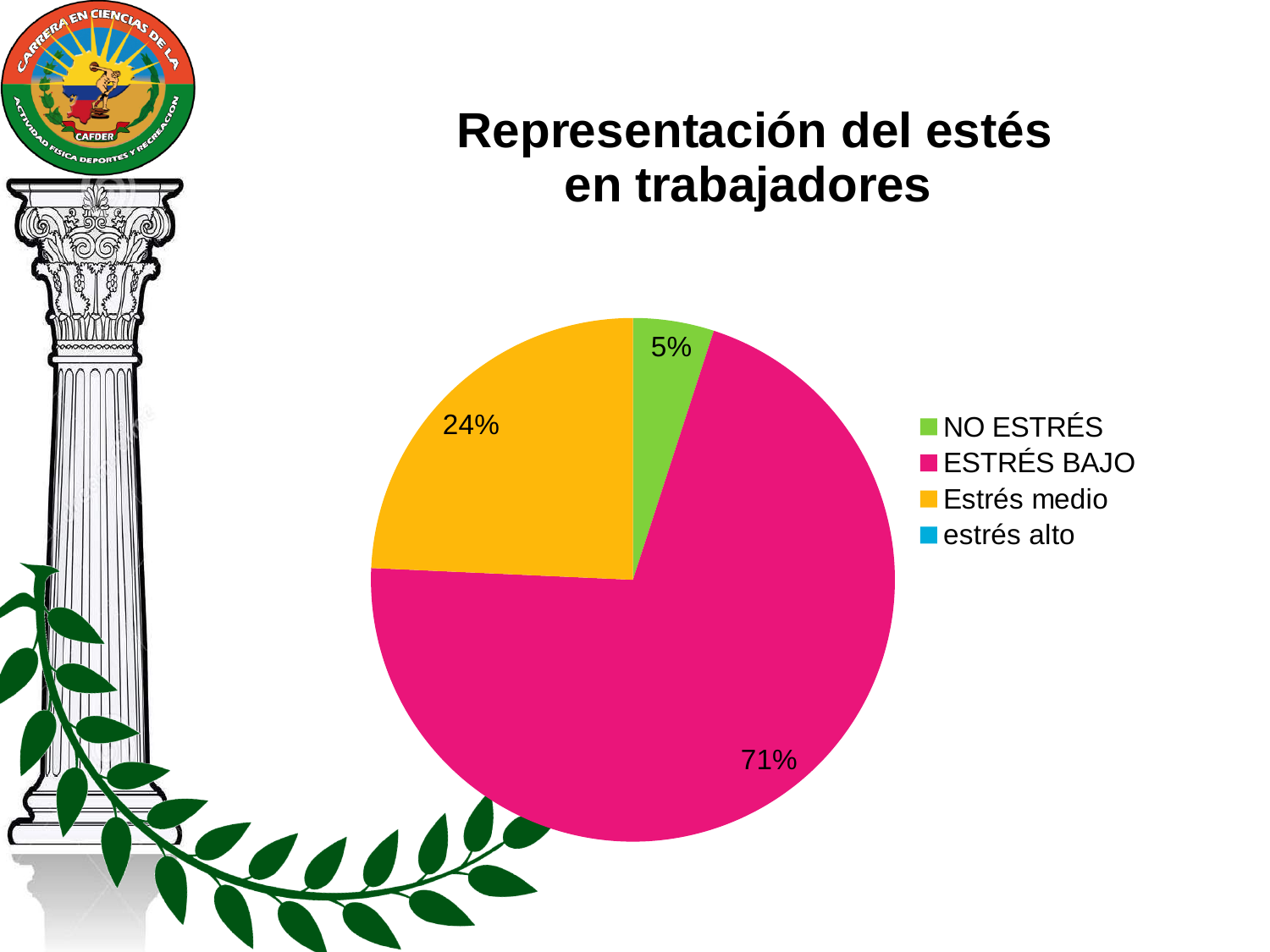
Which category has the largest share of the pie? ESTRÉS BAJO Among the slices with printed labels, which category has the smallest share? NO ESTRÉS What percentage of the pie corresponds to NO ESTRÉS? 5% Which is larger, the share for Estrés medio or the share for NO ESTRÉS? Estrés medio What kind of chart is shown on the slide? Pie chart What is the title of the chart? Representación del estés en trabajadores What percentage of the pie corresponds to ESTRÉS BAJO? 71% How many categories does the legend list? 4 What colour is the ESTRÉS BAJO slice? Pink What percentage of the pie corresponds to Estrés medio? 24% What is the difference in percentage points between ESTRÉS BAJO and Estrés medio? 47 What is the combined share of NO ESTRÉS and Estrés medio? 29%